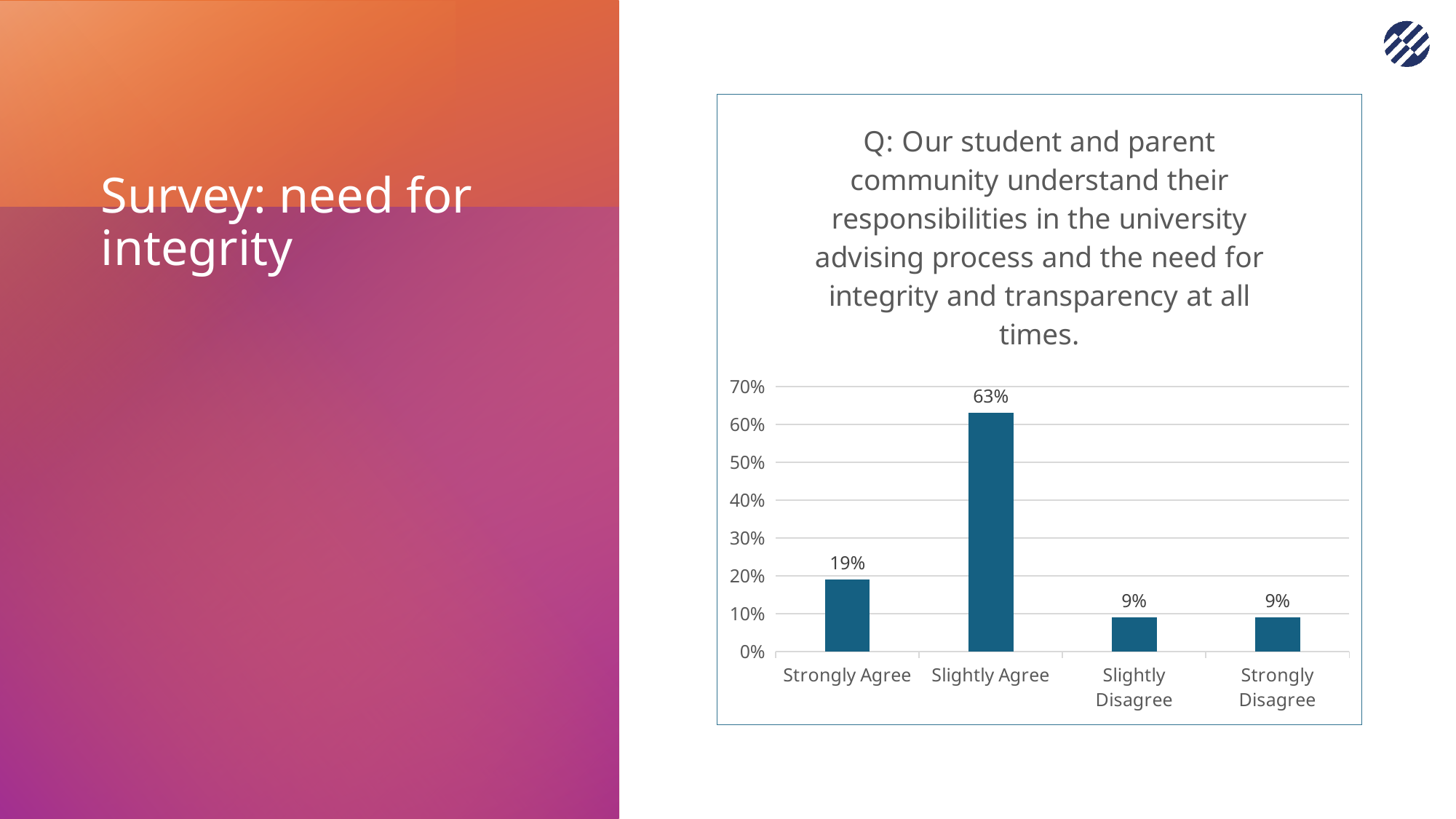
Is the value for Slightly Agree greater or less than 60%? greater What is the difference in percentage points between Strongly Agree and Slightly Disagree? 10 How many response categories are shown on the x axis? 4 What percentage of respondents answered Slightly Disagree? 9% Which response category has the highest percentage? Slightly Agree What is the highest value shown on the vertical axis? 70% Which is larger, the value for Strongly Agree or the value for Strongly Disagree? Strongly Agree What kind of chart is shown on the slide? bar chart What percentage of respondents answered Strongly Disagree? 9% What percentage of respondents answered Strongly Agree? 19% What percentage of respondents answered Slightly Agree? 63% What is the difference in percentage points between Slightly Agree and Strongly Agree? 44